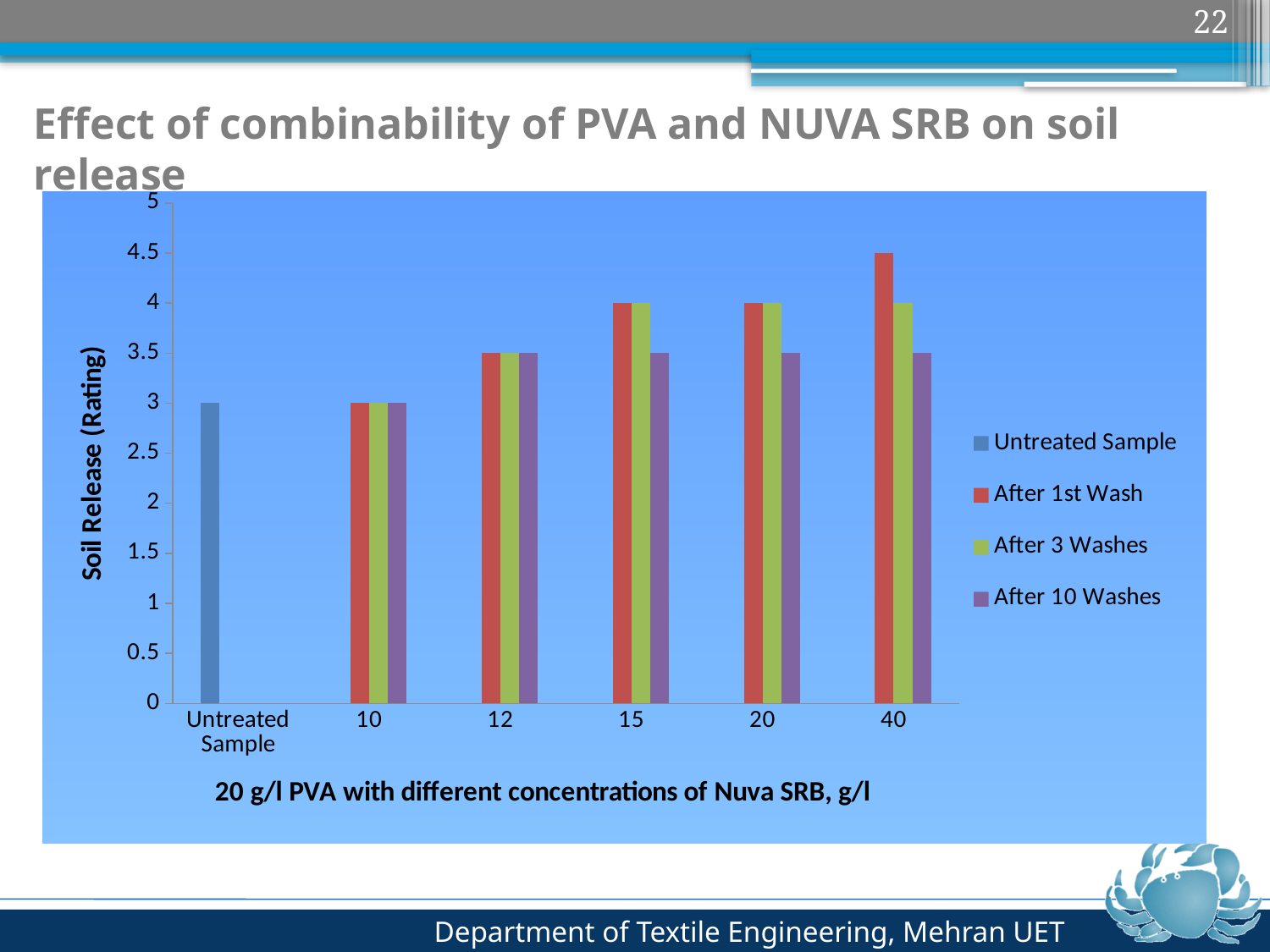
What is the After 1st Wash soil release rating at 40 g/l Nuva SRB? 4.5 Which concentration has the highest After 1st Wash soil release rating? 40 What is the After 3 Washes soil release rating at 12 g/l Nuva SRB? 3.5 Which is larger at 20 g/l Nuva SRB: the After 1st Wash rating or the After 10 Washes rating? After 1st Wash Does the After 1st Wash soil release rating rise or fall as the Nuva SRB concentration increases from 10 to 40 g/l? rise What is the soil release rating of the Untreated Sample? 3 What is the After 10 Washes soil release rating at 15 g/l Nuva SRB? 3.5 How many series does the legend list? 4 What is the label of the y axis? Soil Release (Rating) What is the difference between the After 1st Wash and After 10 Washes ratings at 40 g/l Nuva SRB? 1 How many categories are shown on the x axis? 6 What kind of chart is shown on the slide? bar chart